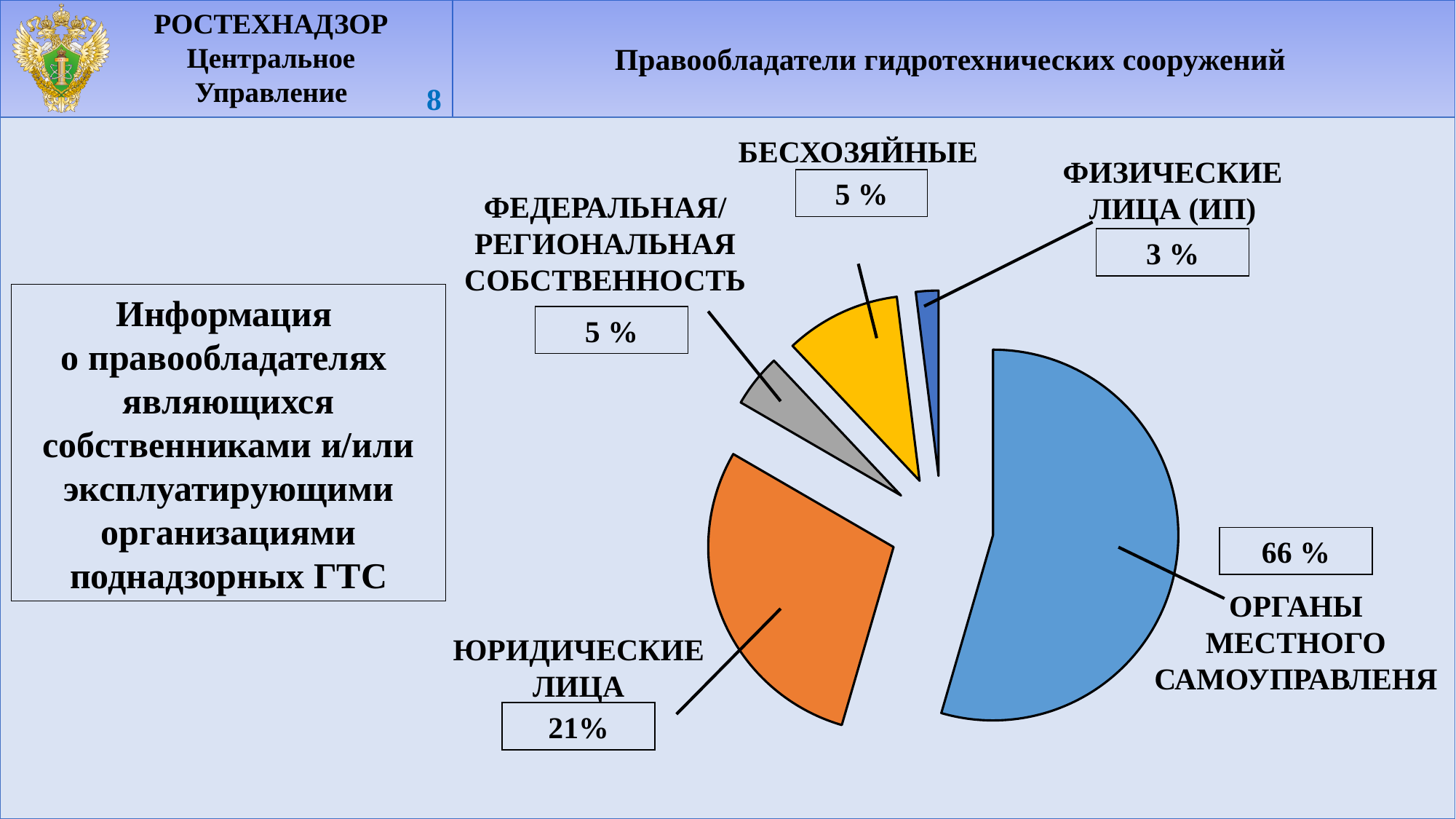
What value is shown for ЮРИДИЧЕСКИЕ ЛИЦА in the pie chart? 21% What is the title of the chart shown in the slide header? Правообладатели гидротехнических сооружений Which is larger: the share for ЮРИДИЧЕСКИЕ ЛИЦА or the share for БЕСХОЗЯЙНЫЕ? ЮРИДИЧЕСКИЕ ЛИЦА Which category has the largest slice of the pie chart? ОРГАНЫ МЕСТНОГО САМОУПРАВЛЕНЯ What share of the pie chart is labelled for ОРГАНЫ МЕСТНОГО САМОУПРАВЛЕНЯ? 66 % What is the difference in percentage points between ОРГАНЫ МЕСТНОГО САМОУПРАВЛЕНЯ and ЮРИДИЧЕСКИЕ ЛИЦА? 45 Which category has the smallest slice of the pie chart? ФИЗИЧЕСКИЕ ЛИЦА (ИП) What type of chart is shown on the slide? Pie chart How many slices does the pie chart have? 5 What value is shown for ФИЗИЧЕСКИЕ ЛИЦА (ИП) in the pie chart? 3 % What value is shown for БЕСХОЗЯЙНЫЕ in the pie chart? 5 % What value is shown for ФЕДЕРАЛЬНАЯ/РЕГИОНАЛЬНАЯ СОБСТВЕННОСТЬ in the pie chart? 5 %